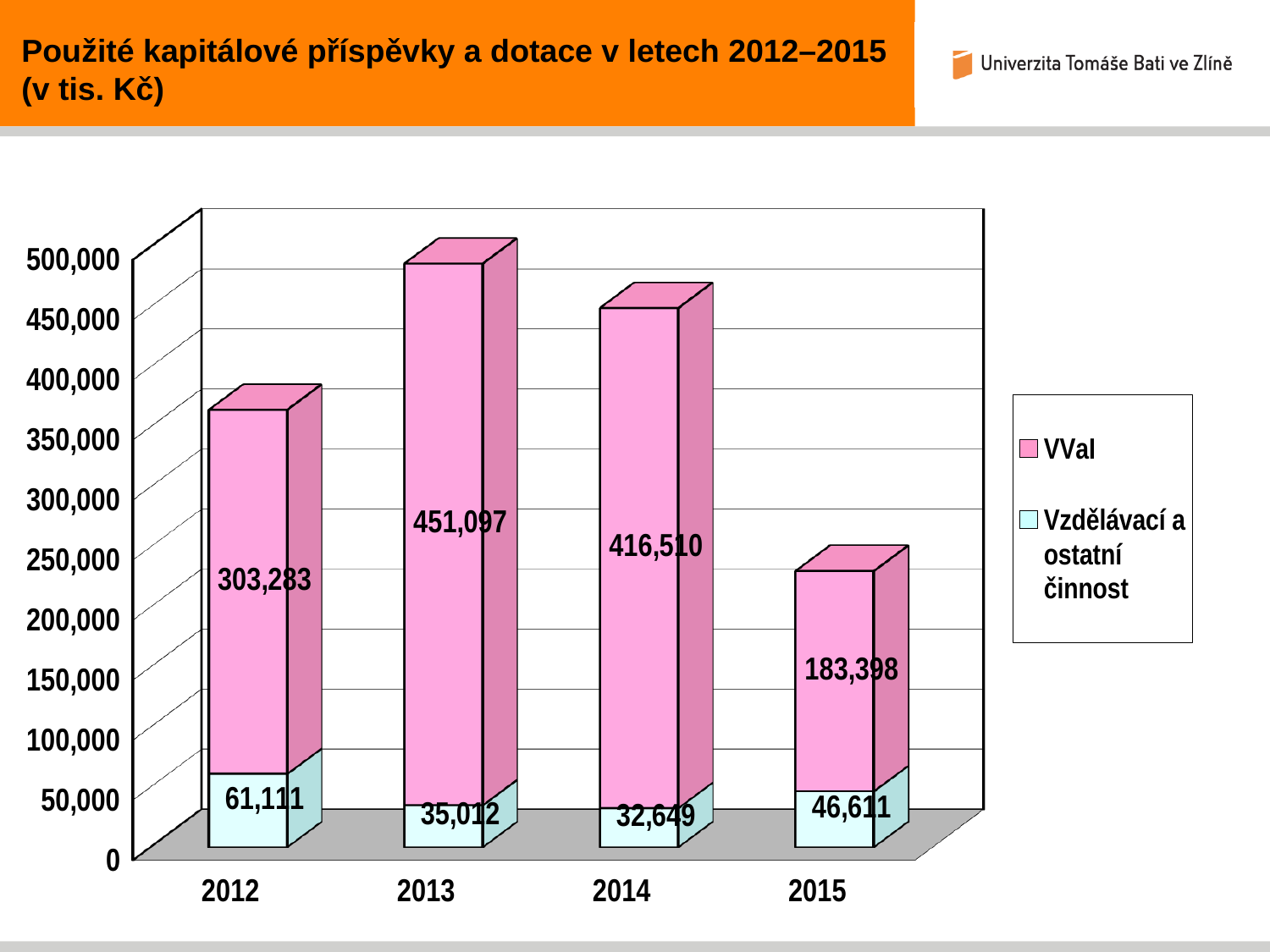
How many years are shown on the x axis? 4 In which year is the Vzdělávací a ostatní činnost value lowest? 2014 Which is larger: the Vzdělávací a ostatní činnost value for 2015 or for 2013? 2015 What is the total of the stacked bar for 2015? 230,009 What is the difference between the VVaI values for 2013 and 2014? 34,587 What kind of chart is shown on the slide? Stacked bar chart What is the total of the stacked bar for 2012? 364,394 In which year is the VVaI value highest? 2013 What is the VVaI value for 2015? 183,398 What is the value for Vzdělávací a ostatní činnost in 2012? 61,111 What is the VVaI value for 2013? 451,097 How many series does the legend list? 2